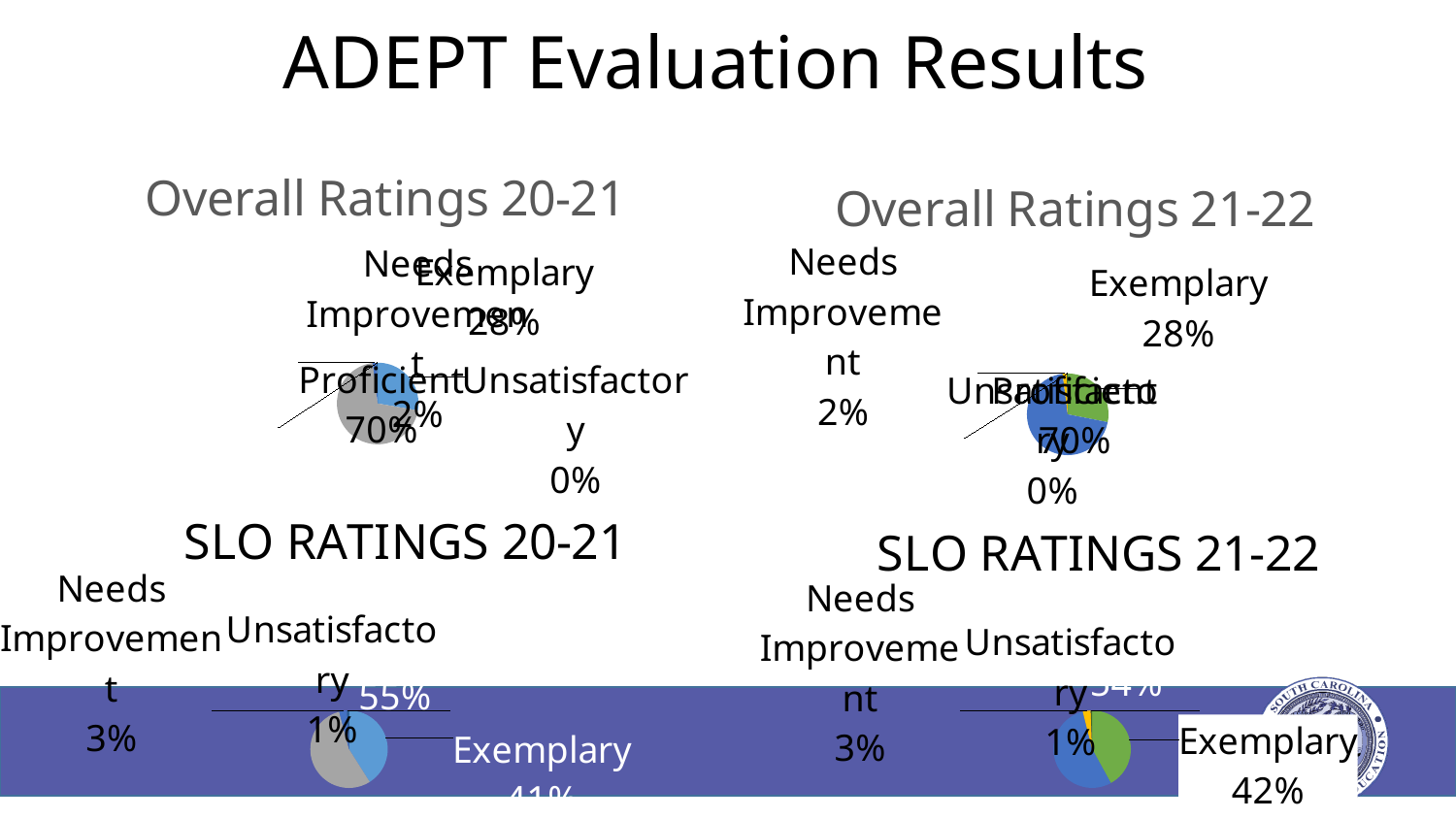
In the SLO RATINGS 21-22 chart, what percentage is Exemplary? 42% In the Overall Ratings 20-21 chart, what percentage is Needs Improvement? 2% In the Overall Ratings 20-21 chart, what percentage is Unsatisfactory? 0% In the Overall Ratings 20-21 chart, what is the difference between Proficient and Exemplary? 42% In the SLO RATINGS 20-21 chart, what percentage is Needs Improvement? 3% In the Overall Ratings 20-21 chart, which category has the largest share? Proficient What type of chart is the Overall Ratings 20-21 chart? Pie chart In the Overall Ratings 21-22 chart, what percentage is Needs Improvement? 2% In the Overall Ratings 20-21 chart, what percentage is Proficient? 70% In the Overall Ratings 20-21 chart, what percentage is Exemplary? 28% In the SLO RATINGS 21-22 chart, what percentage is Unsatisfactory? 1% In the Overall Ratings 21-22 chart, what percentage is Exemplary? 28%